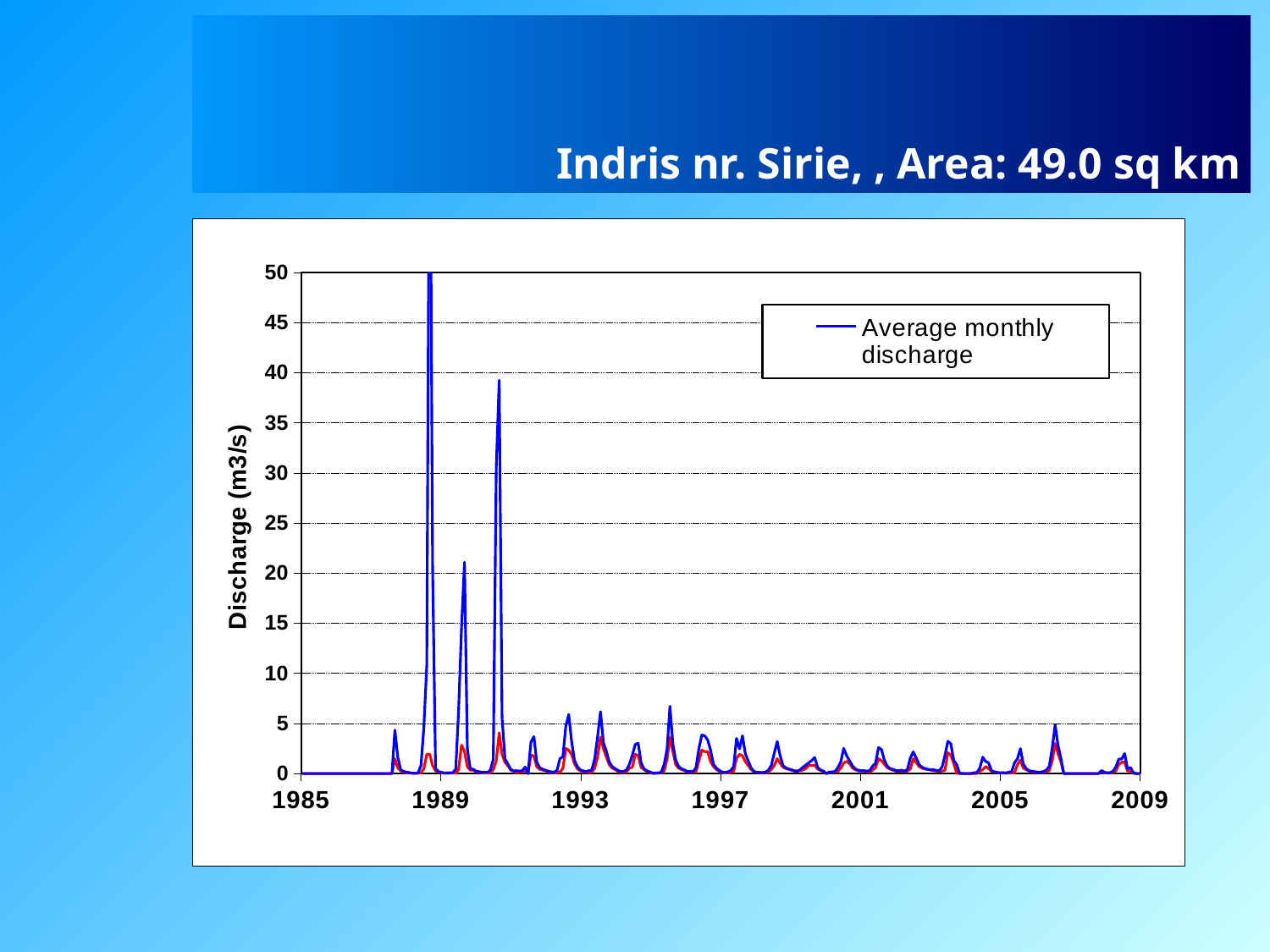
What is the title shown above the chart? Indris nr. Sirie, , Area: 49.0 sq km Is the peak of the blue line just before 1991 greater or less than 35? greater Is the highest peak of the blue line greater or less than 40? greater What kind of chart is shown on the slide? line chart Which is larger: the peak of the blue line just before 1989 or the peak near 1993? the peak just before 1989 Is the peak of the blue line near 1993 greater or less than 10? less How many year labels are shown on the x axis? 7 Do the peak values of the blue line generally rise or fall from 1991 to 2009? fall How many series does the chart legend list? 1 What is the series name shown in the chart legend? Average monthly discharge